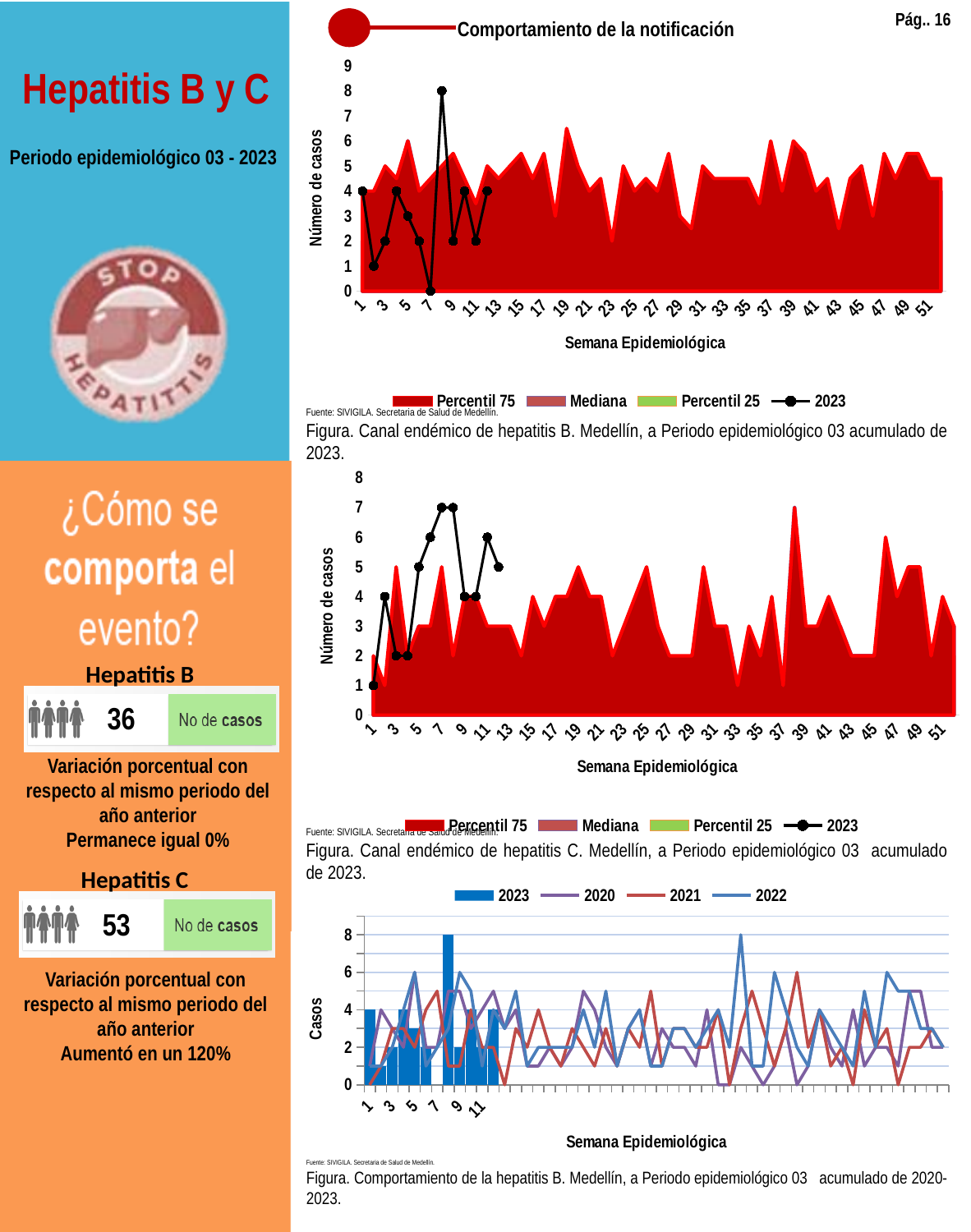
In the bottom chart (Comportamiento de la hepatitis B 2020-2023), which year is shown as bars rather than lines? 2023 In the middle chart (Canal endémico de hepatitis C), what is the highest value reached by the 2023 line? 7 In the top chart (Canal endémico de hepatitis B), what is the difference between the 2023 values at week 8 and week 7? 8 In the bottom chart (Comportamiento de la hepatitis B 2020-2023), which is larger for 2023: the bar at week 1 or the bar at week 2? Week 1 In the middle chart (Canal endémico de hepatitis C), is the 2023 value at week 6 greater or less than 5? greater In the top chart (Canal endémico de hepatitis B), how many points does the 2023 line have? 12 In the top chart (Canal endémico de hepatitis B), what is the value of the 2023 line at week 8? 8 What is the x-axis title of the top chart (Canal endémico de hepatitis B)? Semana Epidemiológica In the top chart (Canal endémico de hepatitis B), how many series does the legend list? 4 In the top chart (Canal endémico de hepatitis B), at which epidemiological week does the 2023 line reach its lowest value? Week 7 In the top chart (Canal endémico de hepatitis B), at which epidemiological week does the 2023 line reach its highest value? Week 8 In the middle chart (Canal endémico de hepatitis C), what is the value of the 2023 line at week 1? 1